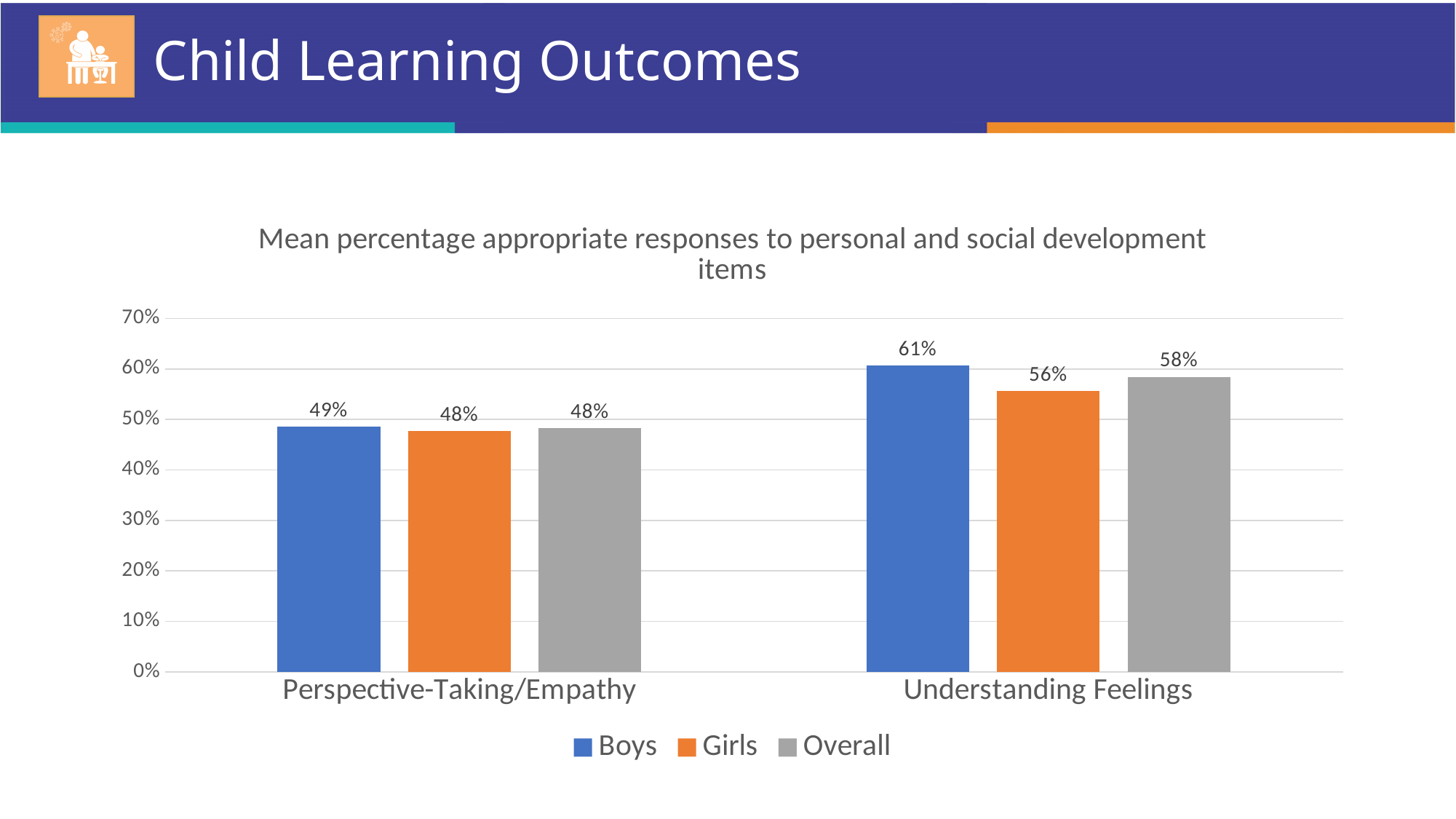
Is the Boys value for Understanding Feelings greater or less than 60%? greater How many categories are shown on the x axis? 2 What kind of chart is shown on the slide? Bar chart What is the value for Girls in the Perspective-Taking/Empathy category? 48% What is the difference between the Boys value and the Girls value for Understanding Feelings? 5% Which series has the lowest value in the Understanding Feelings category? Girls Which is larger: the Boys value for Perspective-Taking/Empathy or the Boys value for Understanding Feelings? Understanding Feelings What is the value for Boys in the Perspective-Taking/Empathy category? 49% What is the Overall value for Understanding Feelings? 58% What is the value for Girls in the Understanding Feelings category? 56% How many series does the legend list? 3 Which series has the highest value in the Understanding Feelings category? Boys